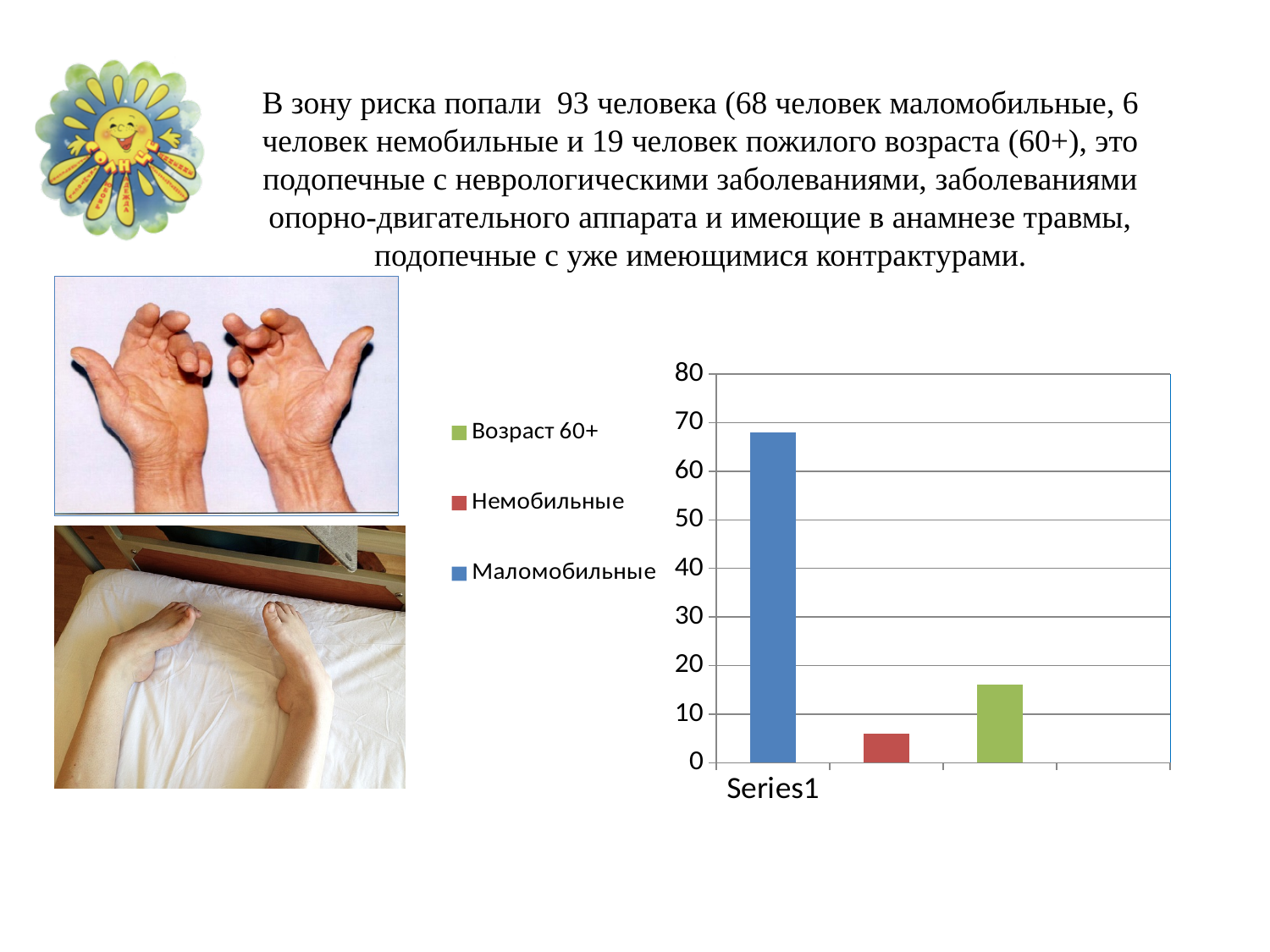
Is the value for Немобильные greater or less than 10? less How many entries does the chart's legend list? 3 How many bars are plotted in the chart? 3 What kind of chart is shown on the slide? bar chart What label is shown on the horizontal axis of the chart? Series1 Is the value for Маломобильные greater or less than 60? greater Which legend entry has the highest bar in the chart? Маломобильные What colour is the bar for Маломобильные in the chart? blue Is the value for Возраст 60+ greater or less than 20? less Which is larger in the chart, the bar for Маломобильные or the bar for Возраст 60+? Маломобильные Which is larger in the chart, the bar for Немобильные or the bar for Возраст 60+? Возраст 60+ Which legend entry has the lowest bar in the chart? Немобильные